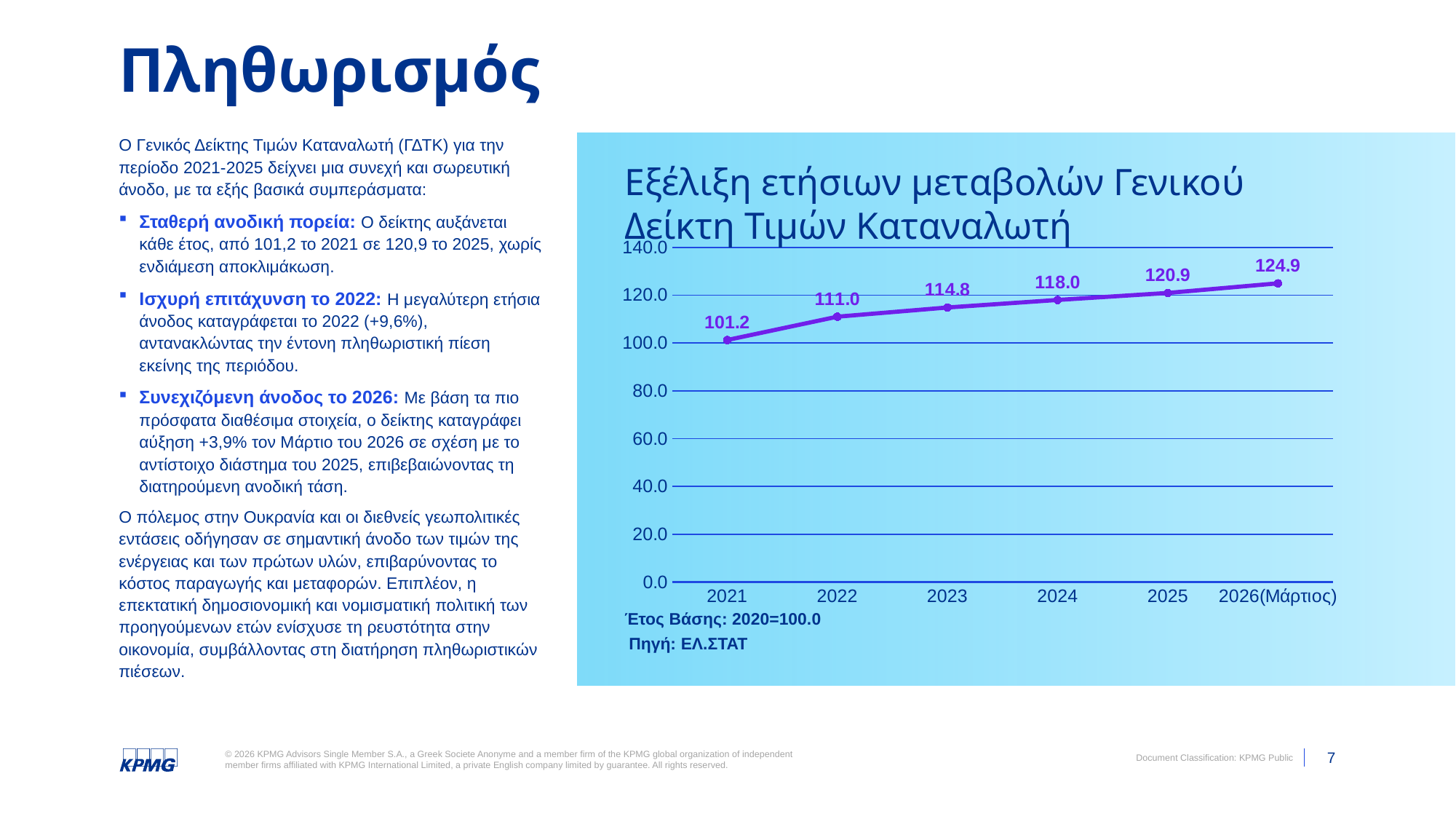
Is the value for 2025 greater or less than 100.0? greater Which year has the lowest value? 2021 Which year has the highest value? 2026(Μάρτιος) What is the value for 2021? 101.2 What is the difference between the values for 2022 and 2021? 9.8 What is the value for 2023? 114.8 What kind of chart is shown? line chart What is the difference between the values for 2025 and 2024? 2.9 How many data points are plotted on the chart? 6 Which is larger, the value for 2024 or the value for 2023? 2024 Do the values rise or fall from 2021 to 2026(Μάρτιος)? rise What is the value for 2026(Μάρτιος)? 124.9